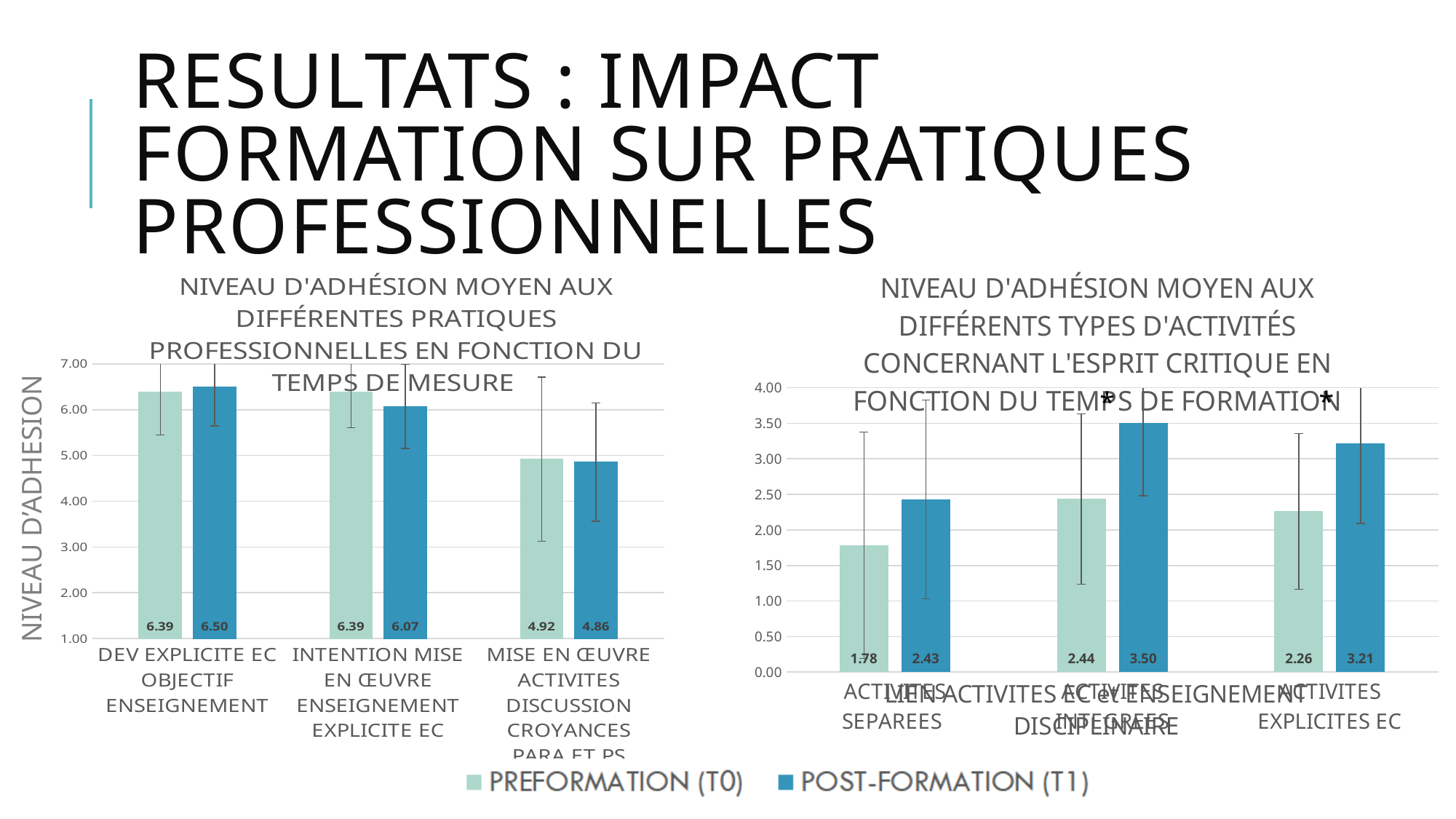
In the right chart, which category has the lowest PREFORMATION (T0) value? ACTIVITES SEPAREES What kind of chart is the left chart? Bar chart In the left chart, what is the PREFORMATION (T0) value for DEV EXPLICITE EC OBJECTIF ENSEIGNEMENT? 6.39 In the left chart, what is the POST-FORMATION (T1) value for MISE EN ŒUVRE ACTIVITES DISCUSSION CROYANCES PARA ET PS? 4.86 How many series does the legend list? 2 In the left chart, what is the difference between the PREFORMATION (T0) and POST-FORMATION (T1) values for INTENTION MISE EN ŒUVRE ENSEIGNEMENT EXPLICITE EC? 0.32 In the right chart, what is the POST-FORMATION (T1) value for ACTIVITES INTEGREES? 3.50 In the right chart, which is larger for ACTIVITES EXPLICITES EC: the PREFORMATION (T0) value or the POST-FORMATION (T1) value? POST-FORMATION (T1) In the right chart, what is the PREFORMATION (T0) value for ACTIVITES SEPAREES? 1.78 In the right chart, what is the difference between the POST-FORMATION (T1) and PREFORMATION (T0) values for ACTIVITES INTEGREES? 1.06 How many categories are shown in the right chart? 3 In the left chart, which category has the lowest POST-FORMATION (T1) value? MISE EN ŒUVRE ACTIVITES DISCUSSION CROYANCES PARA ET PS